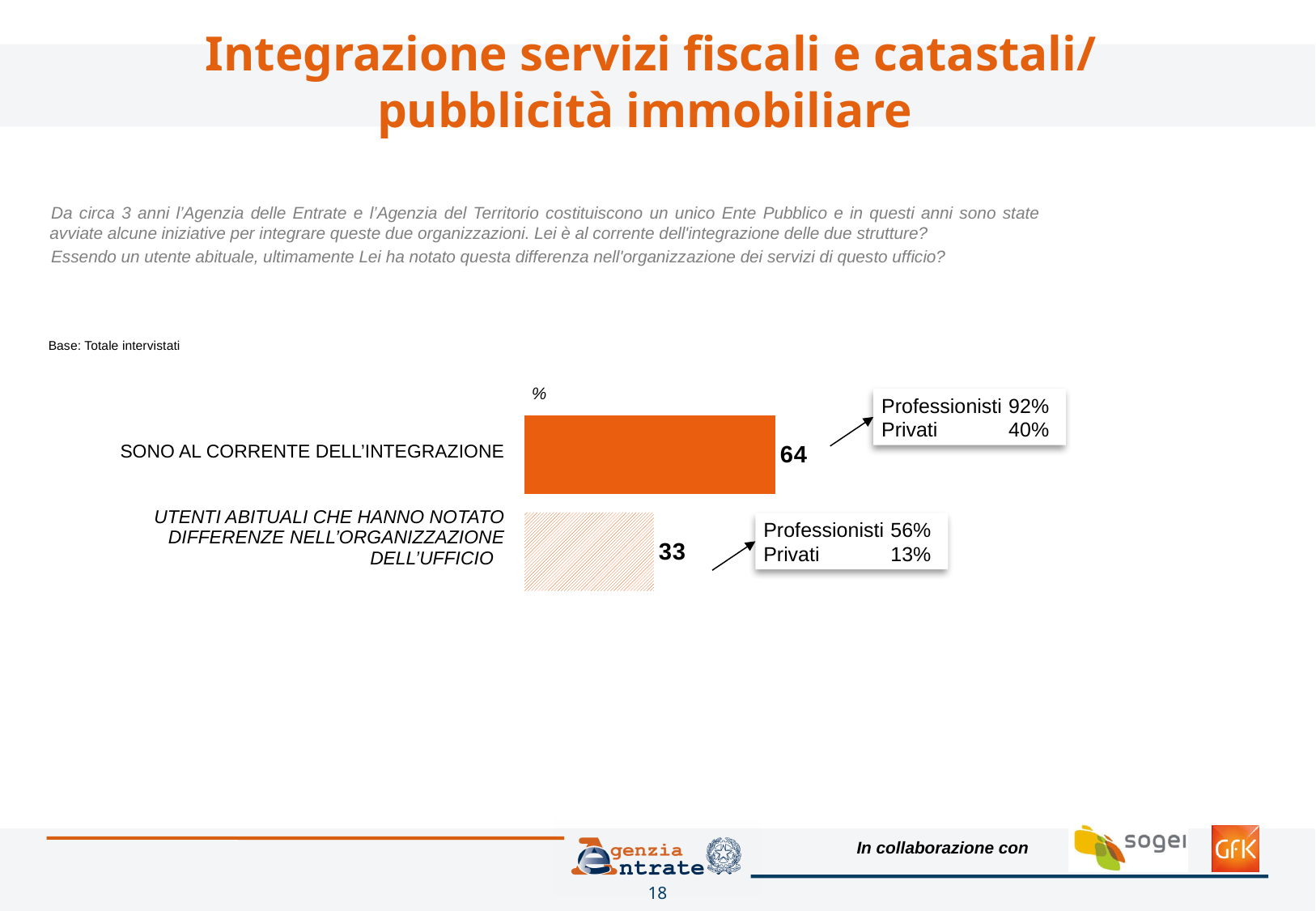
How many bars does the chart show? 2 Which category has the lowest value? UTENTI ABITUALI CHE HANNO NOTATO DIFFERENZE NELL'ORGANIZZAZIONE DELL'UFFICIO What is the value for "SONO AL CORRENTE DELL'INTEGRAZIONE"? 64 What is the difference between the value for "SONO AL CORRENTE DELL'INTEGRAZIONE" and the value for "UTENTI ABITUALI CHE HANNO NOTATO DIFFERENZE NELL'ORGANIZZAZIONE DELL'UFFICIO"? 31 What is the value for "UTENTI ABITUALI CHE HANNO NOTATO DIFFERENZE NELL'ORGANIZZAZIONE DELL'UFFICIO"? 33 According to the callout next to the "SONO AL CORRENTE DELL'INTEGRAZIONE" bar, what is the percentage for Professionisti? 92% What kind of chart is shown on the slide? Bar chart According to the callout next to the "UTENTI ABITUALI CHE HANNO NOTATO DIFFERENZE NELL'ORGANIZZAZIONE DELL'UFFICIO" bar, what is the percentage for Privati? 13% According to the callout next to the "SONO AL CORRENTE DELL'INTEGRAZIONE" bar, what is the percentage for Privati? 40% Which is larger: the value for "SONO AL CORRENTE DELL'INTEGRAZIONE" or the value for "UTENTI ABITUALI CHE HANNO NOTATO DIFFERENZE NELL'ORGANIZZAZIONE DELL'UFFICIO"? SONO AL CORRENTE DELL'INTEGRAZIONE What is the difference between the Professionisti and Privati percentages in the callout for "UTENTI ABITUALI CHE HANNO NOTATO DIFFERENZE NELL'ORGANIZZAZIONE DELL'UFFICIO"? 43% Which category has the highest value? SONO AL CORRENTE DELL'INTEGRAZIONE